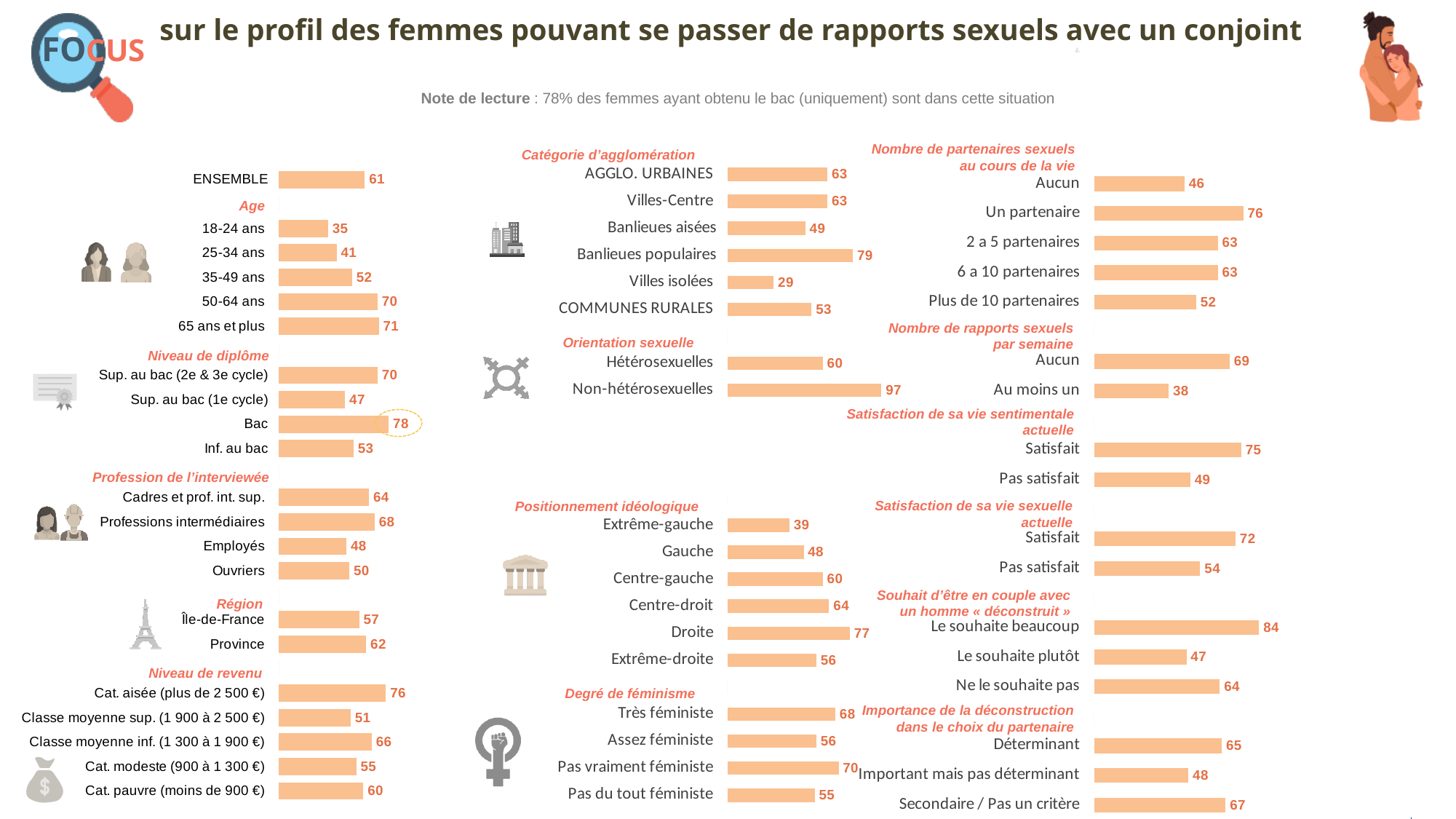
In the "Nombre de rapports sexuels par semaine" chart, what is the difference between "Aucun" and "Au moins un"? 31 In the "Souhait d'être en couple avec un homme « déconstruit »" chart, which category has the highest value? Le souhaite beaucoup In the "Positionnement idéologique" chart, which is larger, "Droite" or "Gauche"? Droite In the "Age" chart, which age group has the lowest value? 18-24 ans In the "Catégorie d'agglomération" chart, what is the difference between "Banlieues populaires" and "Villes isolées"? 50 In the "Niveau de diplôme" chart, what is the value for "Bac"? 78 In the "Orientation sexuelle" chart, what is the value for "Non-hétérosexuelles"? 97 In the "Catégorie d'agglomération" chart, which category has the highest value? Banlieues populaires What kind of chart is used to show the "Niveau de revenu" data? Bar chart In the "Positionnement idéologique" chart, how many categories are shown? 6 In the "Age" chart, what is the value for "65 ans et plus"? 71 In the "Nombre de partenaires sexuels au cours de la vie" chart, what is the value for "Un partenaire"? 76